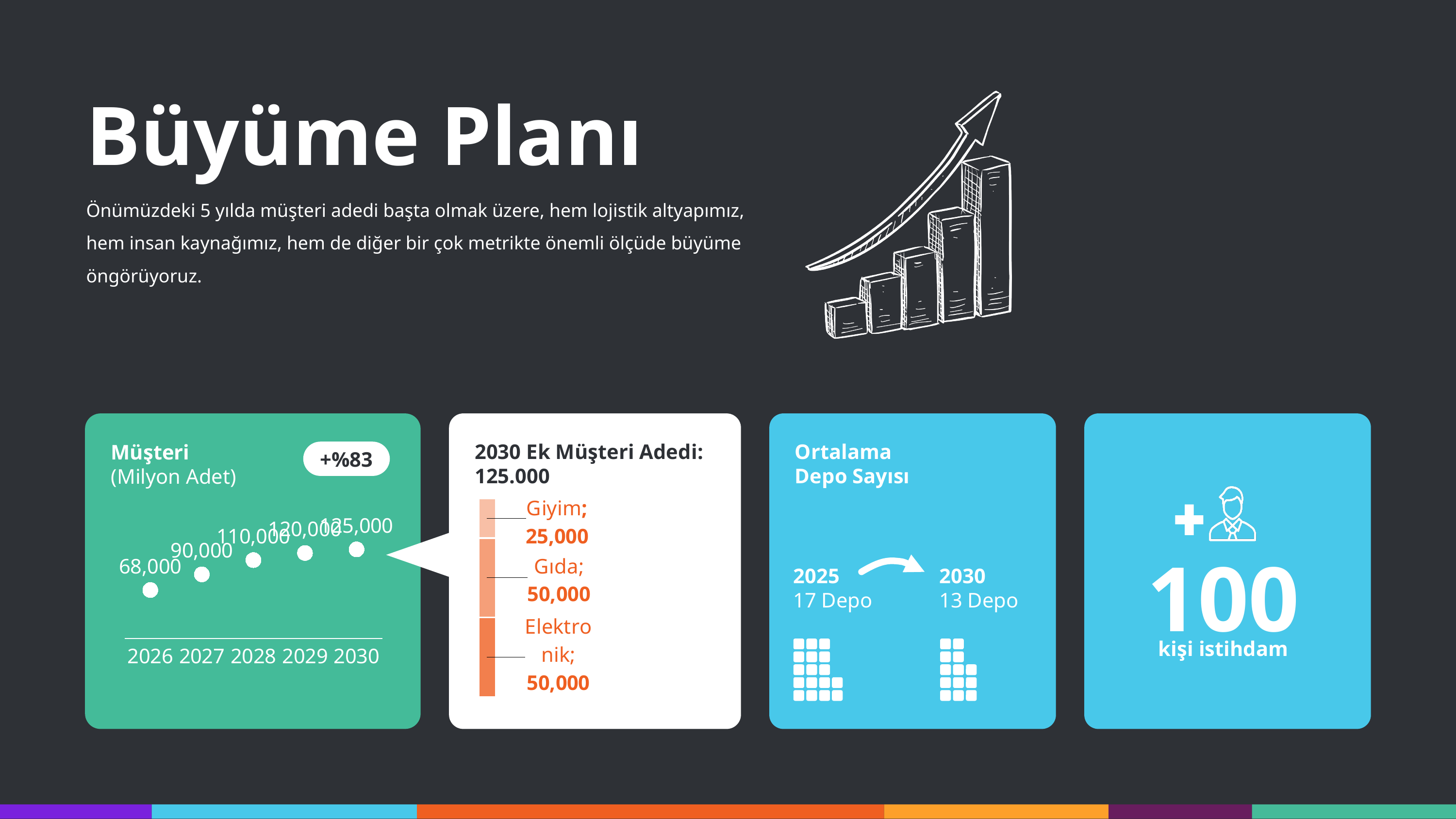
In the Müşteri (Milyon Adet) chart, what is the value for 2030? 125,000 In the Müşteri (Milyon Adet) chart, what is the value for 2027? 90,000 In the Müşteri (Milyon Adet) chart, what is the difference between the 2028 and 2026 values? 42,000 In the 2030 Ek Müşteri Adedi chart, what is the value for Giyim? 25,000 In the Müşteri (Milyon Adet) chart, what is the value for 2028? 110,000 In the 2030 Ek Müşteri Adedi chart, how many segments make up the stacked bar? 3 In the Müşteri (Milyon Adet) chart, how many years are plotted? 5 In the 2030 Ek Müşteri Adedi chart, which segment is the smallest? Giyim In the Müşteri (Milyon Adet) chart, which year has the highest value? 2030 In the Müşteri (Milyon Adet) chart, what is the value for 2026? 68,000 In the Müşteri (Milyon Adet) chart, do the values rise or fall from 2026 to 2030? rise In the Müşteri (Milyon Adet) chart, which year has the lowest value? 2026